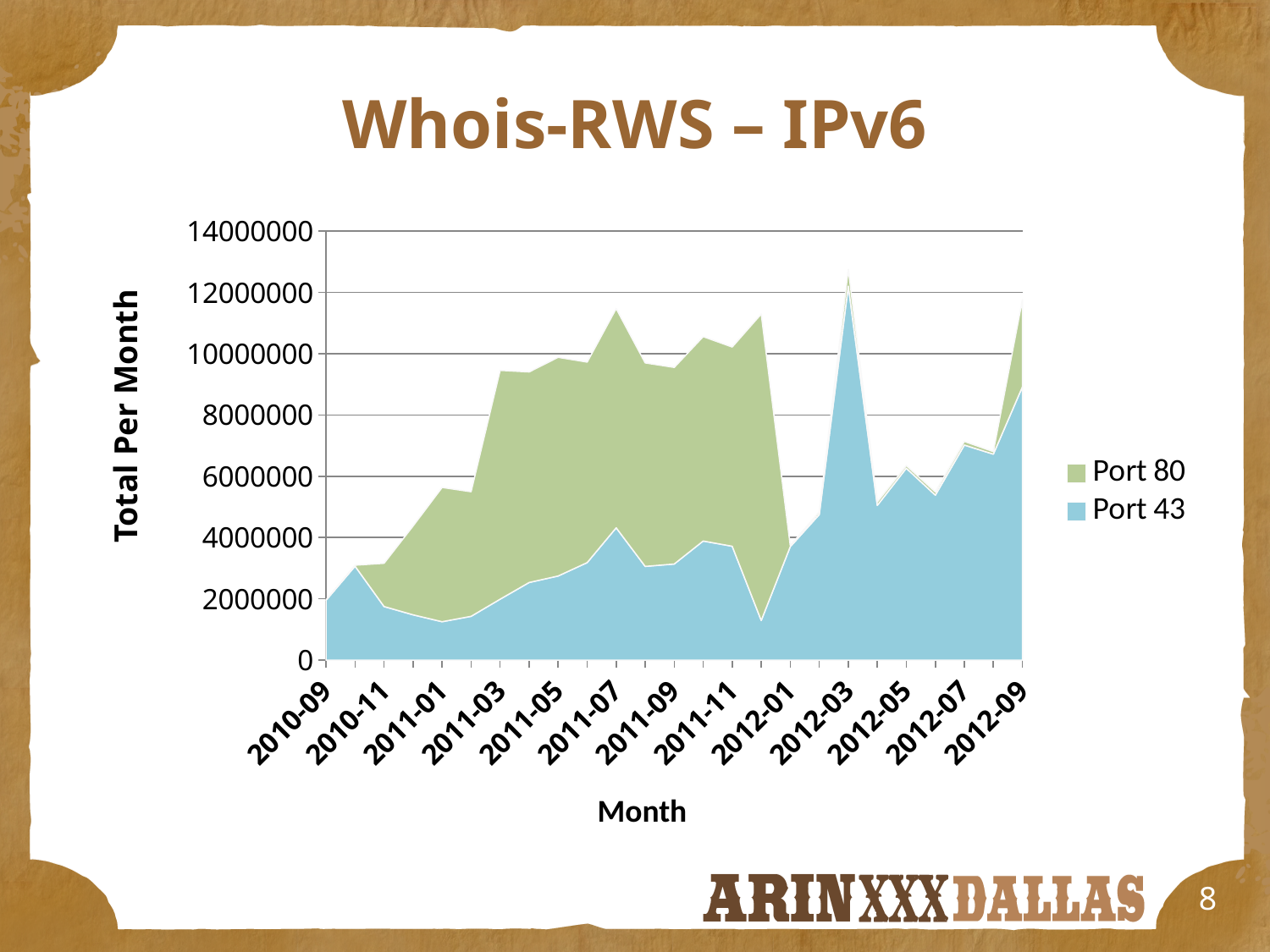
How many series does the legend list? 2 What is the title of the vertical axis? Total Per Month Is the value for Port 43 in 2011-01 greater or less than 2000000? less What are the two series named in the legend? Port 80 and Port 43 In 2012-09, which series has the larger value, Port 80 or Port 43? Port 43 How many month labels are printed along the x axis? 13 What kind of chart is shown on the slide? Area chart Is the combined total of Port 80 and Port 43 in 2011-07 greater or less than 10000000? greater Is the value for Port 43 in 2012-01 greater or less than 2000000? greater Does the Port 43 value rise or fall from 2012-05 to 2012-09? Rise In which month does Port 43 reach its highest value? 2012-03